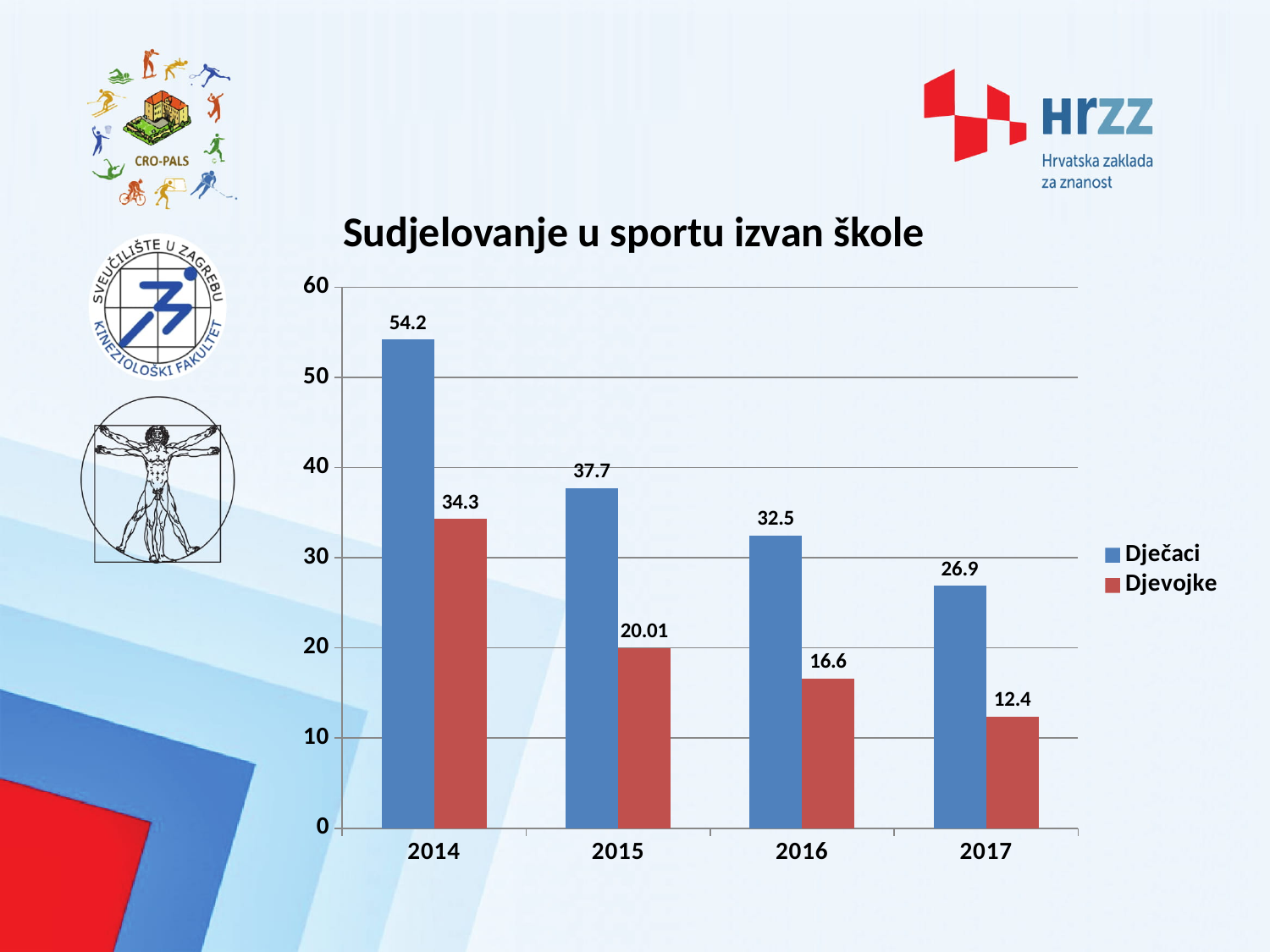
What is the value for Djevojke in 2017? 12.4 How many series does the legend list? 2 In which year is the value for Djevojke lowest? 2017 In which year is the value for Dječaci highest? 2014 What kind of chart is shown on the slide? bar chart What is the value for Dječaci in 2014? 54.2 Is the value for Dječaci in 2017 greater or less than 30? less What is the value for Djevojke in 2015? 20.01 Do the values for Djevojke rise or fall from 2014 to 2017? fall How many years are shown on the x axis? 4 Which is larger in 2015, the value for Dječaci or for Djevojke? Dječaci What is the difference between the Dječaci and Djevojke values in 2016? 15.9